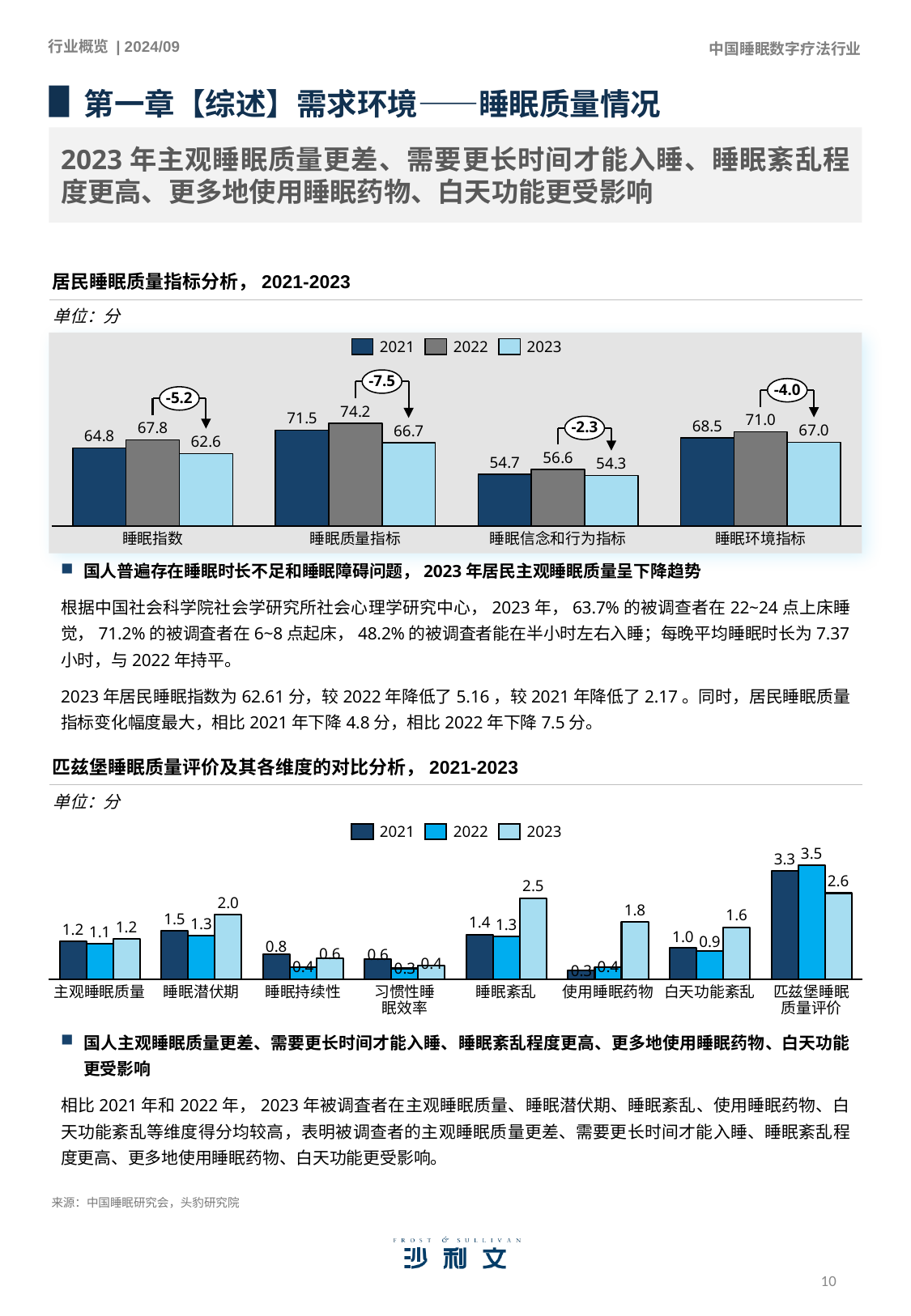
在“居民睡眠质量指标分析，2021-2023”图中，睡眠指数从2022年到2023年是上升还是下降？ 下降 在“匹兹堡睡眠质量评价及其各维度的对比分析，2021-2023”图中，2023年睡眠紊乱的得分是多少？ 2.5 在“居民睡眠质量指标分析，2021-2023”图中，2021年各指标中哪一项的值最低？ 睡眠信念和行为指标 在“居民睡眠质量指标分析，2021-2023”图中，2023年睡眠信念和行为指标的值是多少？ 54.3 在“匹兹堡睡眠质量评价及其各维度的对比分析，2021-2023”图中，2023年使用睡眠药物的得分是多少？ 1.8 在“匹兹堡睡眠质量评价及其各维度的对比分析，2021-2023”图中，2023年睡眠潜伏期与2021年相比哪个更高？ 2023年 在“匹兹堡睡眠质量评价及其各维度的对比分析，2021-2023”图中，横轴共有多少个类别？ 8 “匹兹堡睡眠质量评价及其各维度的对比分析，2021-2023”是什么类型的图表？ 柱状图（条形图） 在“居民睡眠质量指标分析，2021-2023”图中，图例列出了几个系列？ 3 在“居民睡眠质量指标分析，2021-2023”图中，2023年各指标中哪一项的值最高？ 睡眠环境指标 在“居民睡眠质量指标分析，2021-2023”图中，2022年睡眠质量指标的值是多少？ 74.2 在“居民睡眠质量指标分析，2021-2023”图中，睡眠环境指标2022年与2023年的差值是多少？ 4.0